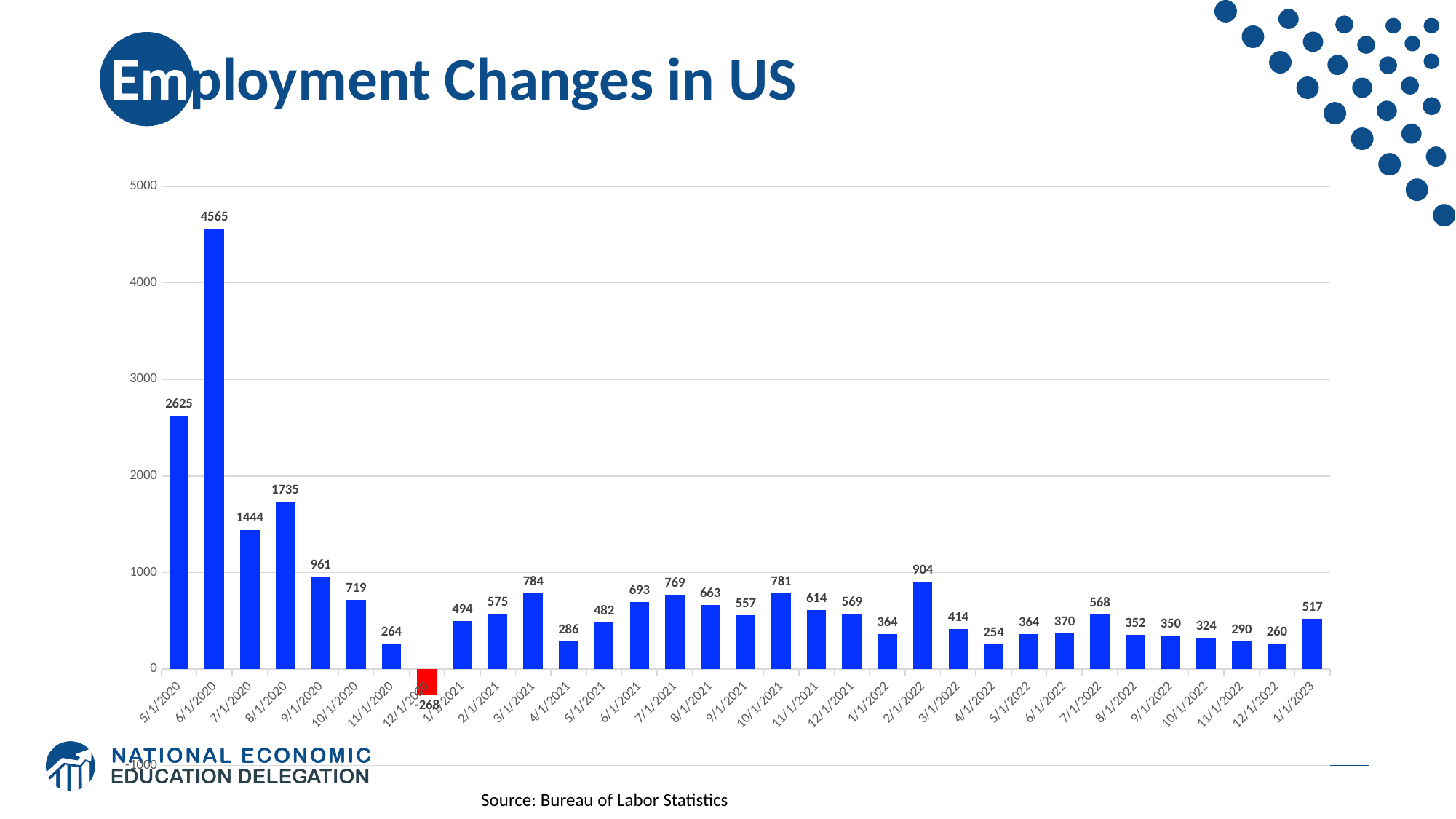
What is the difference between the values for 5/1/2020 and 7/1/2020? 1181 Do the values generally rise or fall from 5/1/2020 to 11/1/2020? fall Which bar is coloured red instead of blue? 12/1/2020 What is the employment change value for 2/1/2022? 904 How many months are plotted in the chart? 33 What type of chart is shown on the slide? Bar chart What is the employment change value for 1/1/2023? 517 Which is larger, the value for 10/1/2021 or the value for 3/1/2021? 3/1/2021 Which month has the lowest employment change? 12/1/2020 What is the employment change value for 6/1/2020? 4565 Is the value for 8/1/2020 greater or less than 2000? less Which month has the highest employment change? 6/1/2020